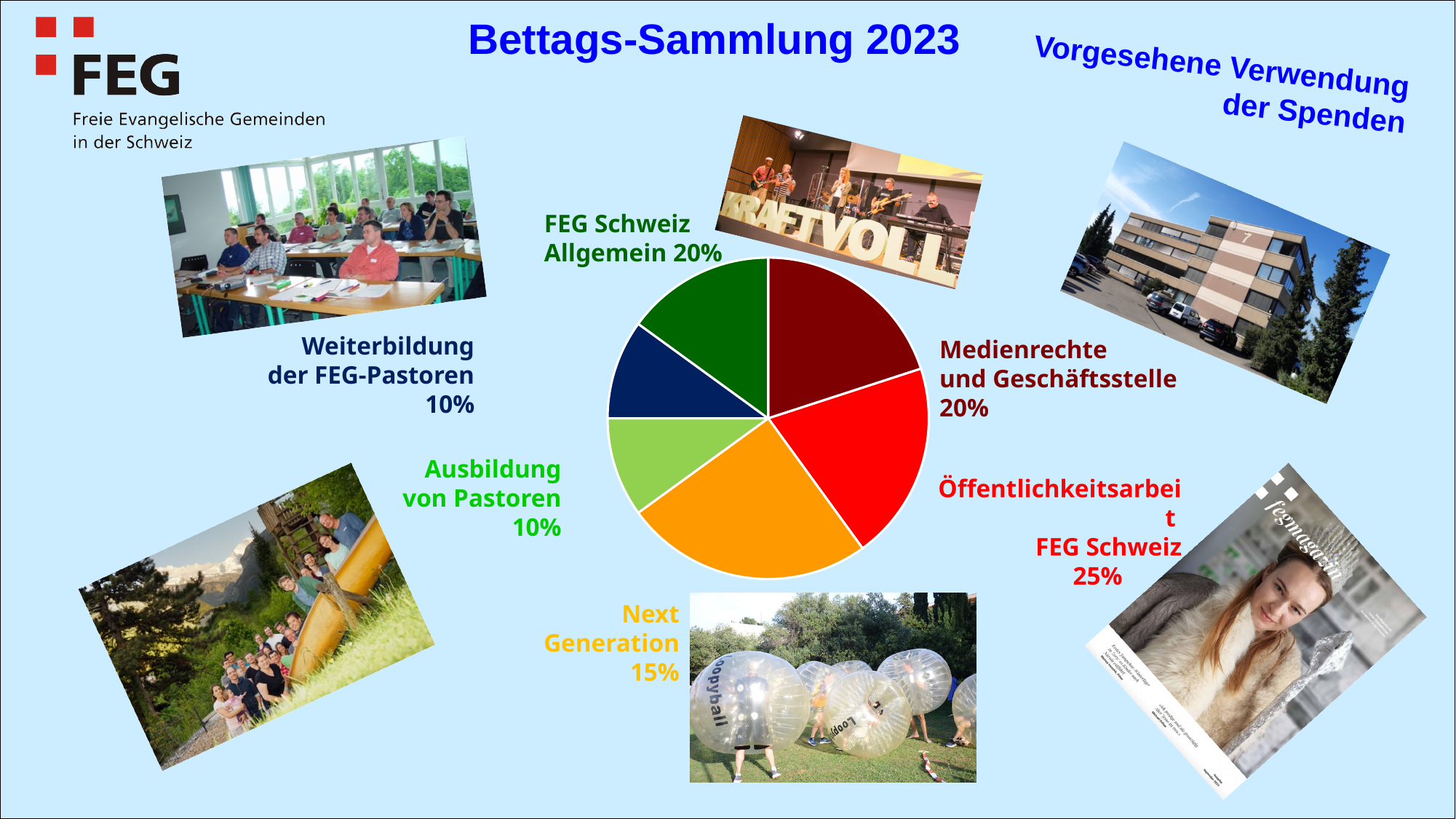
What share of the donations is planned for Ausbildung von Pastoren? 10% What share of the donations is planned for FEG Schweiz Allgemein? 20% What kind of chart is shown on the slide? pie chart What is the title of the slide above the pie chart? Bettags-Sammlung 2023 Which is larger, the share for Next Generation or the share for Weiterbildung der FEG-Pastoren? Next Generation What share of the donations is planned for Öffentlichkeitsarbeit FEG Schweiz? 25% What share of the donations is planned for Medienrechte und Geschäftsstelle? 20% Which category receives the largest share of the donations? Öffentlichkeitsarbeit FEG Schweiz What share of the donations is planned for Next Generation? 15% What is the difference in percentage points between Öffentlichkeitsarbeit FEG Schweiz and Next Generation? 10 What is the combined share of Ausbildung von Pastoren and Weiterbildung der FEG-Pastoren? 20% How many slices does the pie chart have? 6